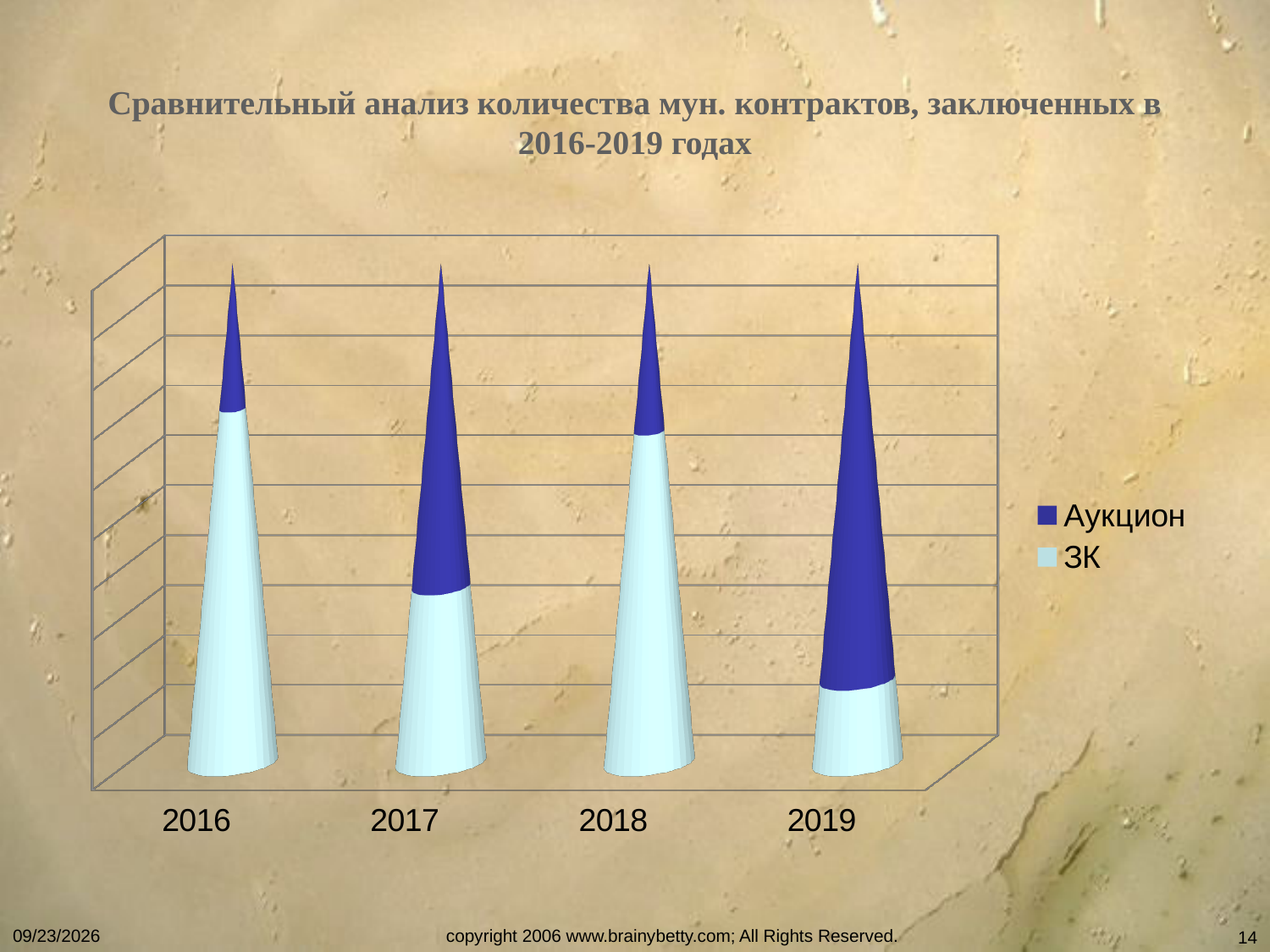
In 2017, which series has the larger value, Аукцион or ЗК? Аукцион In which year is the Аукцион portion of the bar the largest? 2019 In 2019, which series has the larger value, Аукцион or ЗК? Аукцион What kind of chart is shown on the slide? bar chart In 2018, which series has the larger value, Аукцион or ЗК? ЗК What are the two series named in the chart legend? Аукцион and ЗК Which colour represents the Аукцион series in the chart? dark blue In which year is the ЗК portion of the bar the largest? 2016 How many series does the chart legend list? 2 In which year is the ЗК portion of the bar the smallest? 2019 How many years (categories) are shown on the x axis of the chart? 4